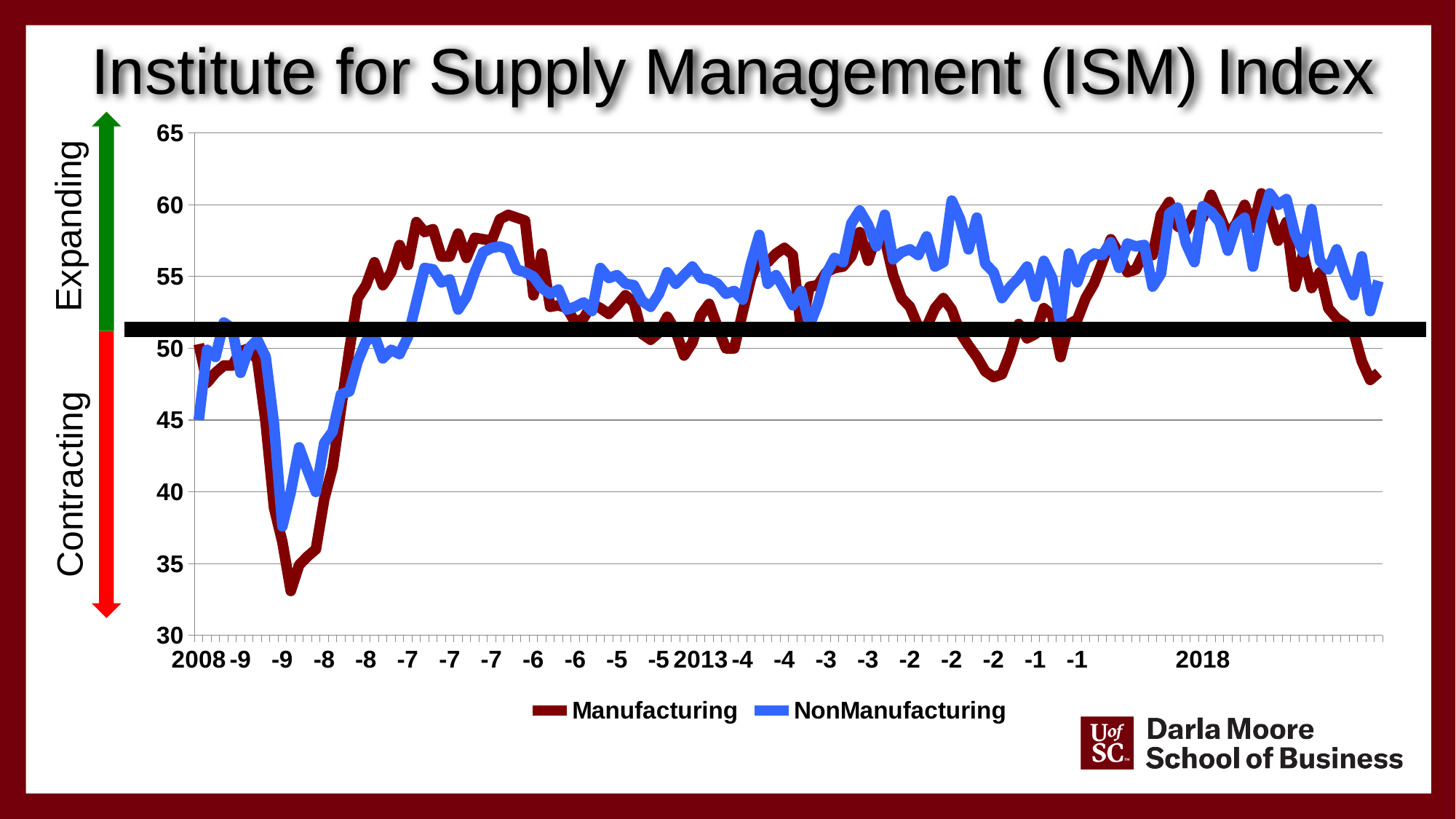
Which colour represents the NonManufacturing series in the chart? Blue What kind of chart is shown on the slide? Line chart Does the Manufacturing series rise or fall from the start of 2008 to its low point in 2009? Fall Is the final (rightmost) value of the Manufacturing series greater or less than 50? less Does the Manufacturing series rise or fall from its peak near 2018 to the end of the chart? Fall Is the lowest value of the Manufacturing series (around 2009) greater or less than 35? less How many series does the legend list? 2 Is the lowest value of the NonManufacturing series (around 2009) greater or less than 35? greater At the trough around 2009, which series has the lower value, Manufacturing or NonManufacturing? Manufacturing What is the title of the chart? Institute for Supply Management (ISM) Index At the rightmost end of the chart, which series has the higher value, Manufacturing or NonManufacturing? NonManufacturing